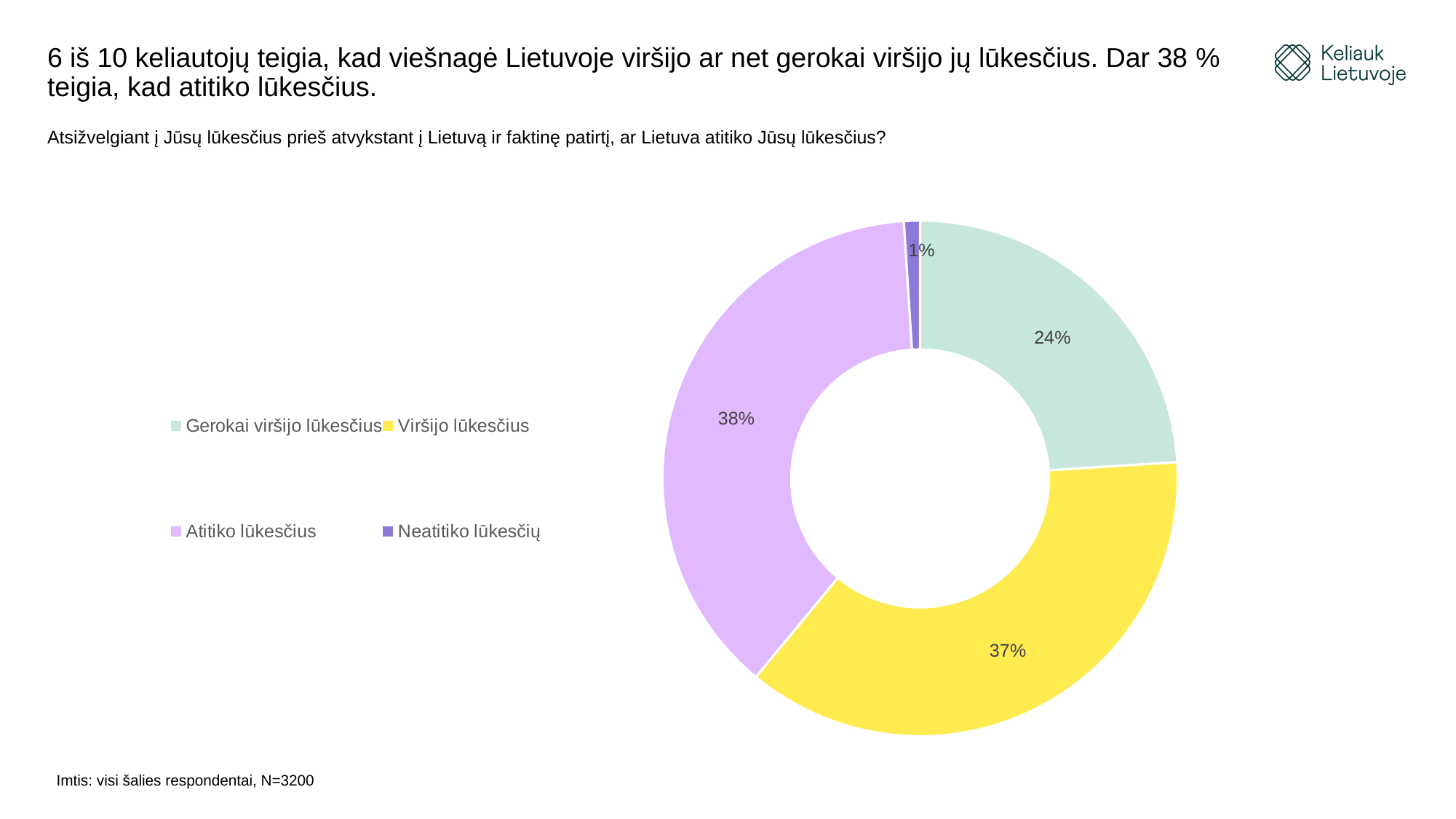
Which is larger: the share for 'Gerokai viršijo lūkesčius' or the share for 'Neatitiko lūkesčių'? Gerokai viršijo lūkesčius What type of chart is shown on the slide? Pie chart (donut) What percentage of respondents said Lithuania 'Gerokai viršijo lūkesčius' (greatly exceeded expectations)? 24% What is the difference in percentage points between 'Viršijo lūkesčius' and 'Gerokai viršijo lūkesčius'? 13 What colour represents 'Atitiko lūkesčius' in the chart? Light purple What percentage of respondents said Lithuania 'Viršijo lūkesčius' (exceeded expectations)? 37% Which response category has the smallest share of the chart? Neatitiko lūkesčių How many response categories are shown in the chart? 4 What is the combined share of 'Gerokai viršijo lūkesčius' and 'Viršijo lūkesčius'? 61% What percentage of respondents said Lithuania 'Neatitiko lūkesčių' (did not meet expectations)? 1% Which response category has the largest share of the chart? Atitiko lūkesčius What percentage of respondents said Lithuania 'Atitiko lūkesčius' (met expectations)? 38%